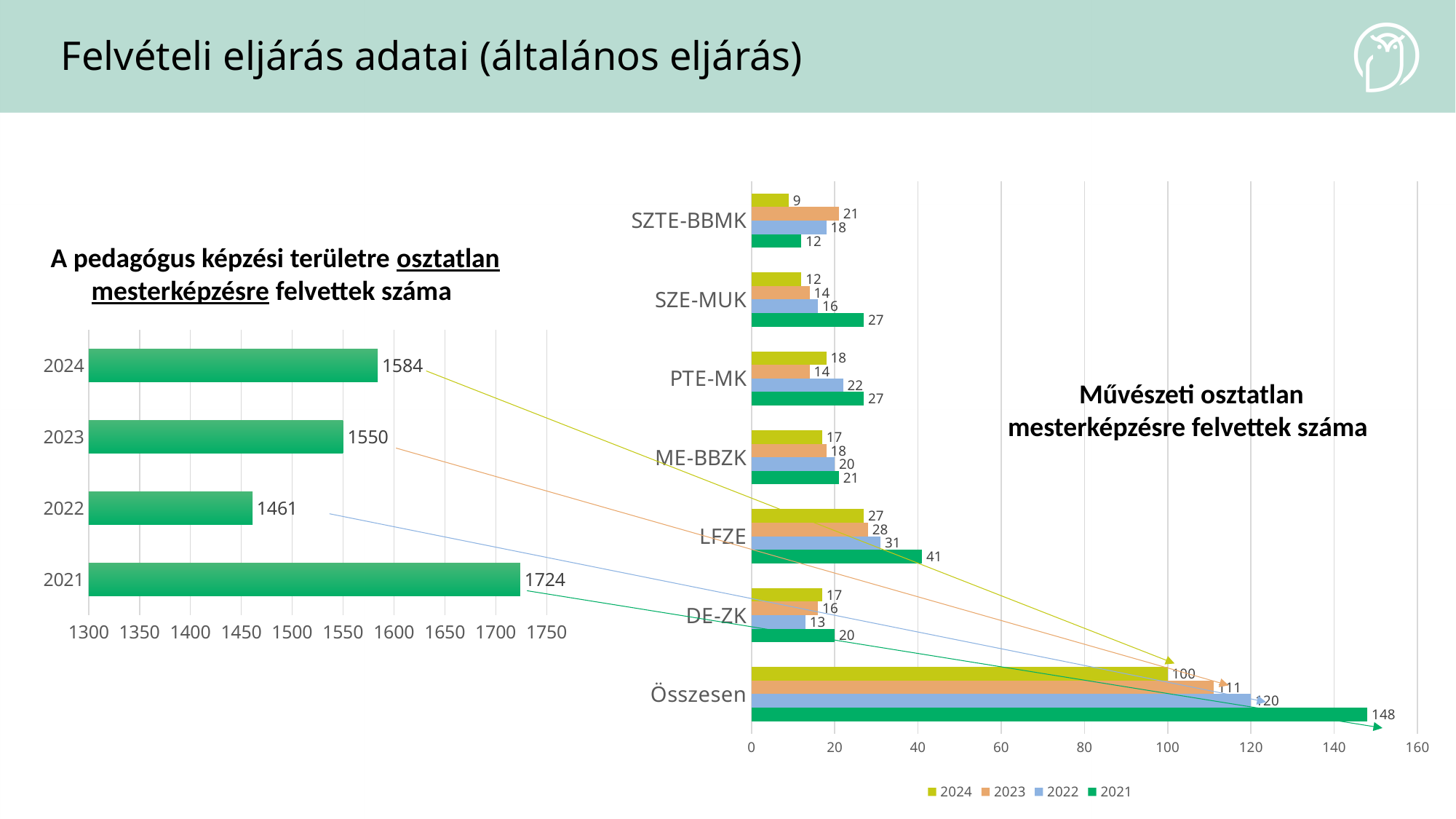
In the left chart (A pedagógus képzési területre osztatlan mesterképzésre felvettek száma), what is the difference between the 2021 and 2024 values? 140 In the right chart (Művészeti osztatlan mesterképzésre felvettek száma), which institution (excluding Összesen) has the highest 2021 value? LFZE In the left chart (A pedagógus képzési területre osztatlan mesterképzésre felvettek száma), what is the value for 2024? 1584 What type of chart is the left chart (A pedagógus képzési területre osztatlan mesterképzésre felvettek száma)? Bar chart In the left chart (A pedagógus képzési területre osztatlan mesterképzésre felvettek száma), how many years are shown? 4 In the right chart (Művészeti osztatlan mesterképzésre felvettek száma), what is the 2021 value for LFZE? 41 In the right chart (Művészeti osztatlan mesterképzésre felvettek száma), how many series does the legend list? 4 In the right chart (Művészeti osztatlan mesterképzésre felvettek száma), what is the difference between the 2021 and 2024 values for Összesen? 48 In the right chart (Művészeti osztatlan mesterképzésre felvettek száma), which is larger for PTE-MK: the 2022 value or the 2023 value? 2022 In the right chart (Művészeti osztatlan mesterképzésre felvettek száma), what is the 2024 value for SZTE-BBMK? 9 In the left chart (A pedagógus képzési területre osztatlan mesterképzésre felvettek száma), which year has the highest value? 2021 In the left chart (A pedagógus képzési területre osztatlan mesterképzésre felvettek száma), which year has the lowest value? 2022